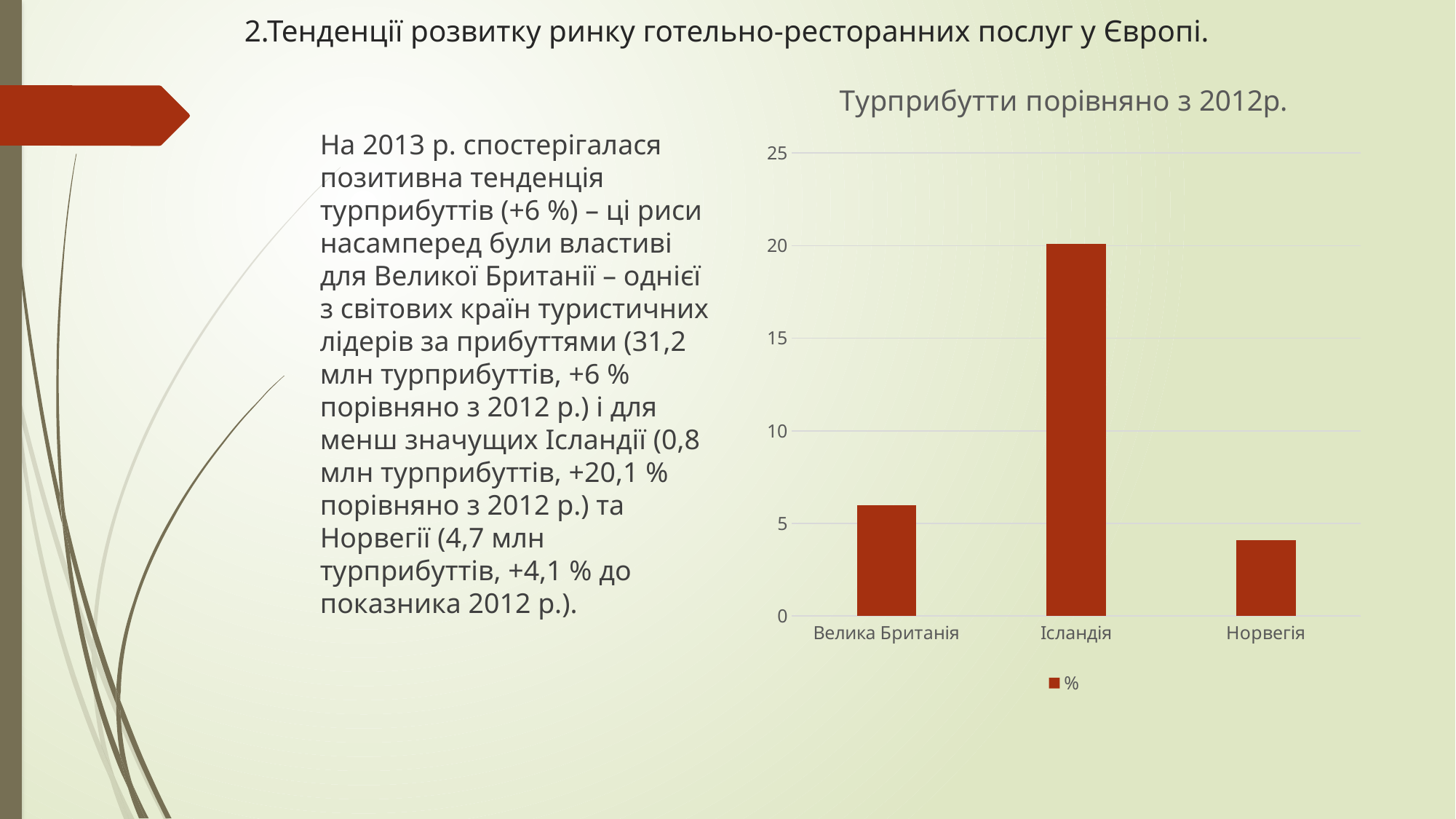
Is the value for Норвегія greater or less than 5? less Is the value for Велика Британія greater or less than 10? less What kind of chart is shown on the slide? bar chart Which category has the highest bar in the chart? Ісландія Which category has the lowest bar in the chart? Норвегія How many series does the chart legend list? 1 How many categories are shown on the x axis of the chart? 3 Which has a larger value, Велика Британія or Норвегія? Велика Британія Which has a larger value, Ісландія or Велика Британія? Ісландія What is the title of the chart? Турприбутти порівняно з 2012р. Is the value for Ісландія greater or less than 15? greater What is the legend entry for the series in the chart? %